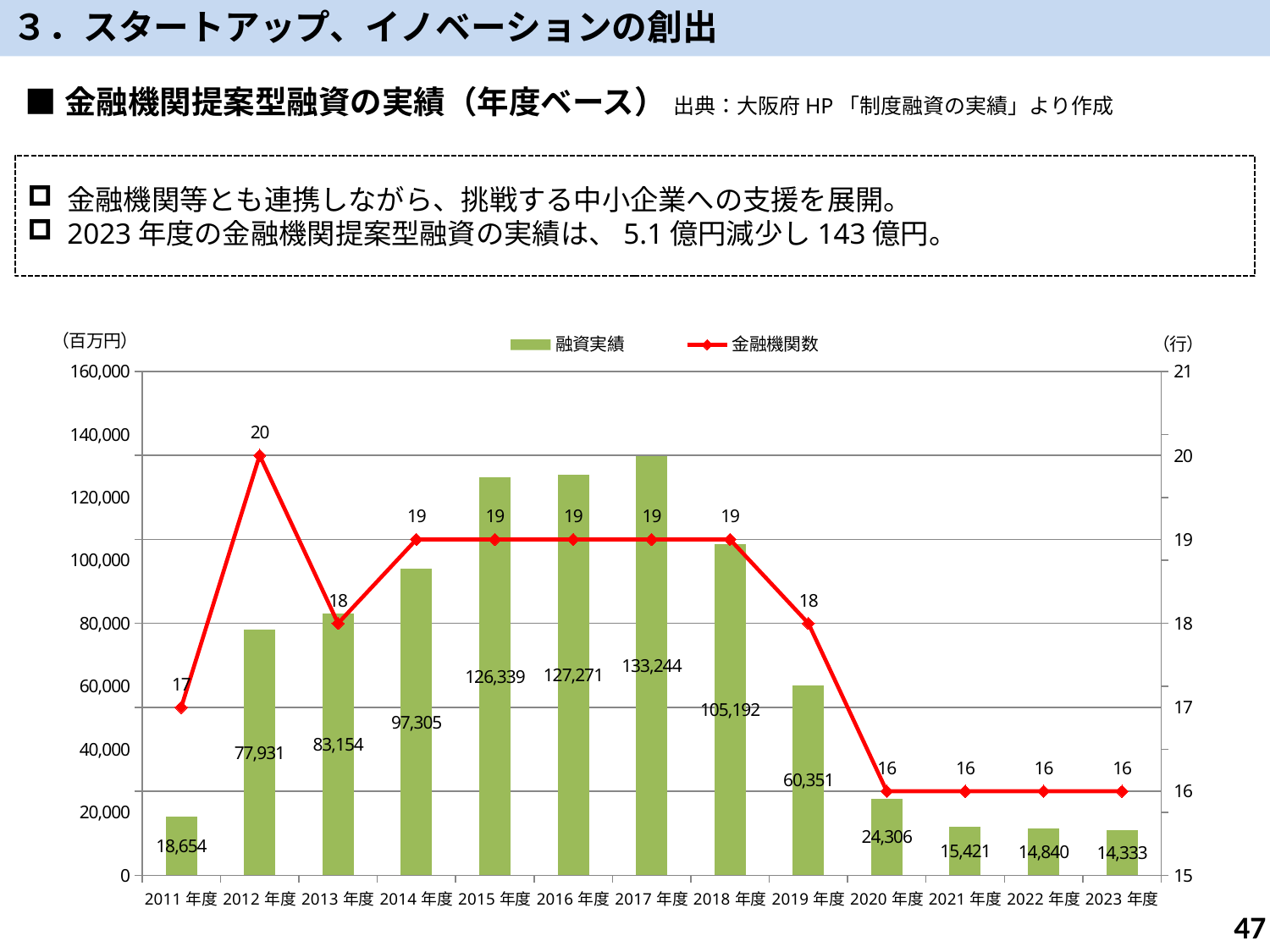
Which fiscal year has the highest 融資実績? 2017年度 How many fiscal years are shown on the x axis? 13 What is the 金融機関数 value for 2012年度? 20 What kind of chart is used to show 融資実績? Bar chart What is the difference in 融資実績 between 2022年度 and 2023年度? 507 What is the 融資実績 value for 2023年度? 14,333 Which fiscal year has the lowest 融資実績? 2023年度 Which is larger, the 融資実績 for 2015年度 or for 2016年度? 2016年度 What unit is shown on the left axis of the chart? 百万円 Does the 融資実績 rise or fall from 2017年度 to 2023年度? Fall How many series does the legend list? 2 What is the 融資実績 value for 2017年度? 133,244